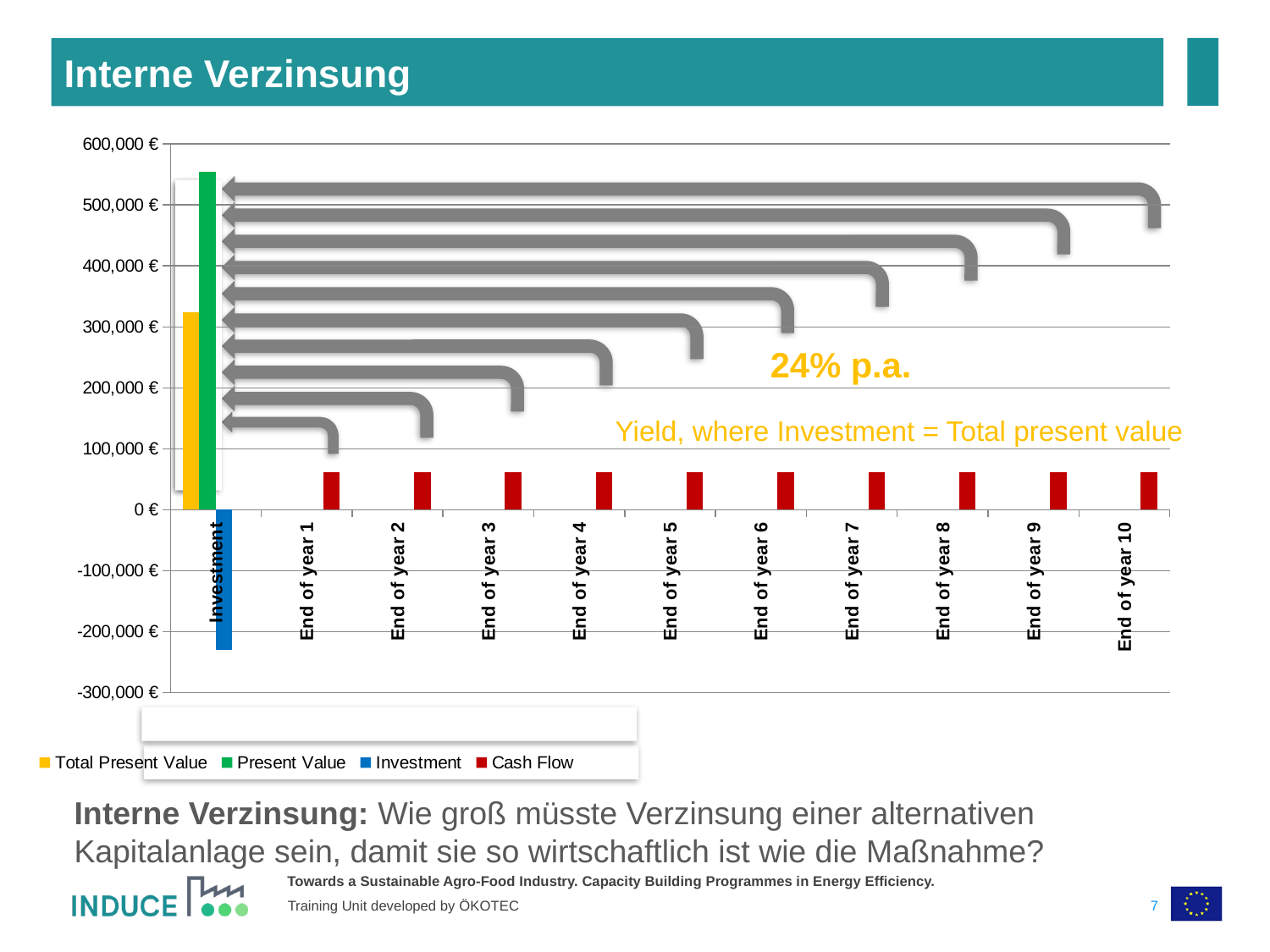
Which series is shown in red in the legend? Cash Flow Is the Total Present Value bar greater or less than 400,000 €? less Is the Investment bar greater or less than -200,000 €? less What kind of chart is shown on the slide? bar chart What yield percentage is annotated on the chart? 24% p.a. Is the Cash Flow bar for End of year 1 greater or less than 100,000 €? less How many categories are shown on the x axis? 11 Which series is the only one with a negative value? Investment Which is larger, the Present Value bar or the Total Present Value bar? Present Value How many series does the legend list? 4